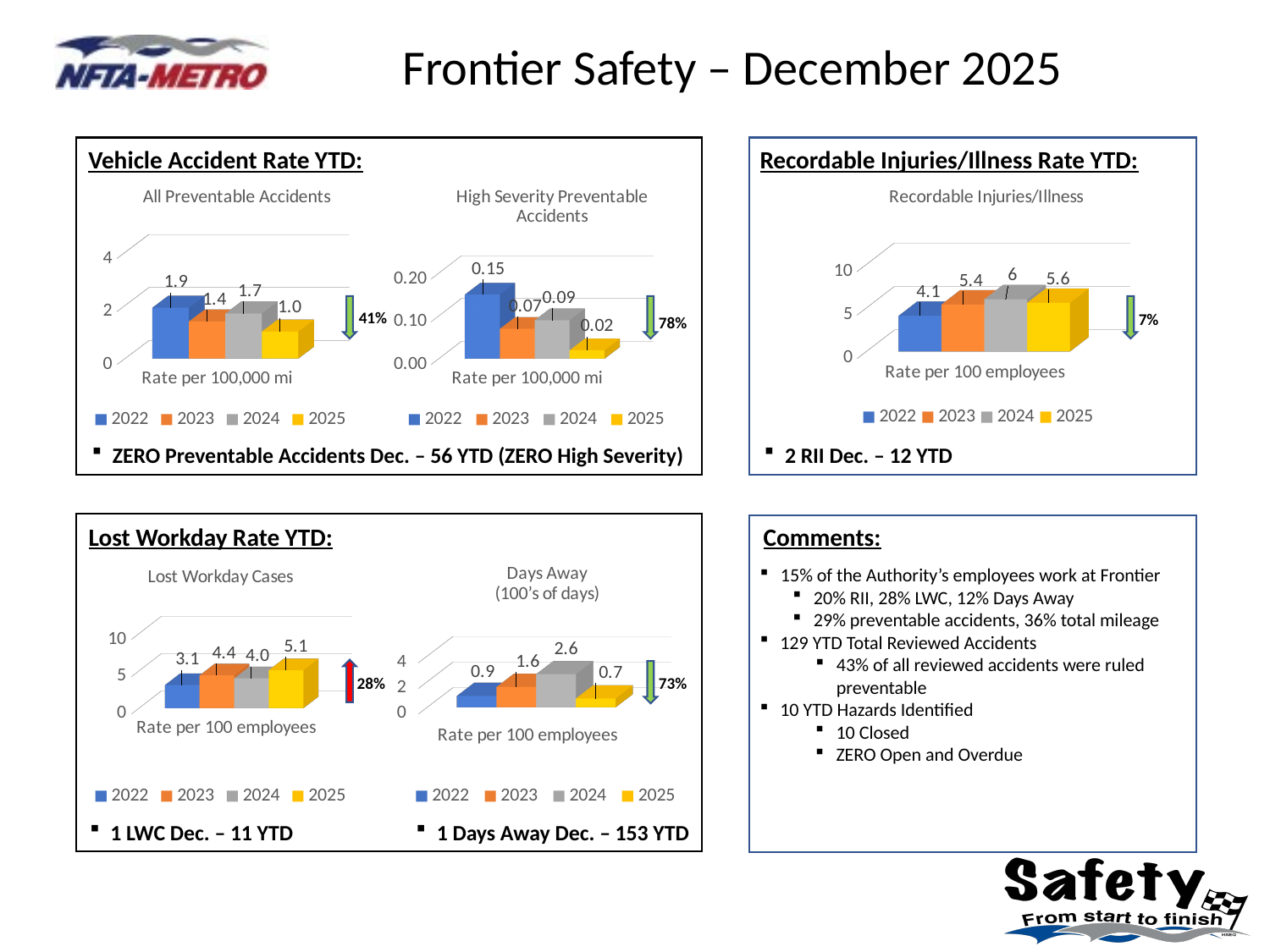
In the High Severity Preventable Accidents chart, which year has the lowest value? 2025 What kind of chart is the Lost Workday Cases chart? Bar chart In the Lost Workday Cases chart, which year has the highest value? 2025 How many series does the legend of the Recordable Injuries/Illness chart list? 4 In the Recordable Injuries/Illness chart, what is the difference between the 2023 and 2022 values? 1.3 In the Recordable Injuries/Illness chart, what is the value for 2024? 6 In the Days Away chart, what is the difference between the 2024 and 2025 values? 1.9 In the Days Away chart, what is the value for 2024? 2.6 In the All Preventable Accidents chart, which year has the highest rate? 2022 In the All Preventable Accidents chart, what is the value for 2025? 1.0 In the Lost Workday Cases chart, is the value for 2023 larger or smaller than the value for 2024? larger In the High Severity Preventable Accidents chart, what is the value for 2022? 0.15